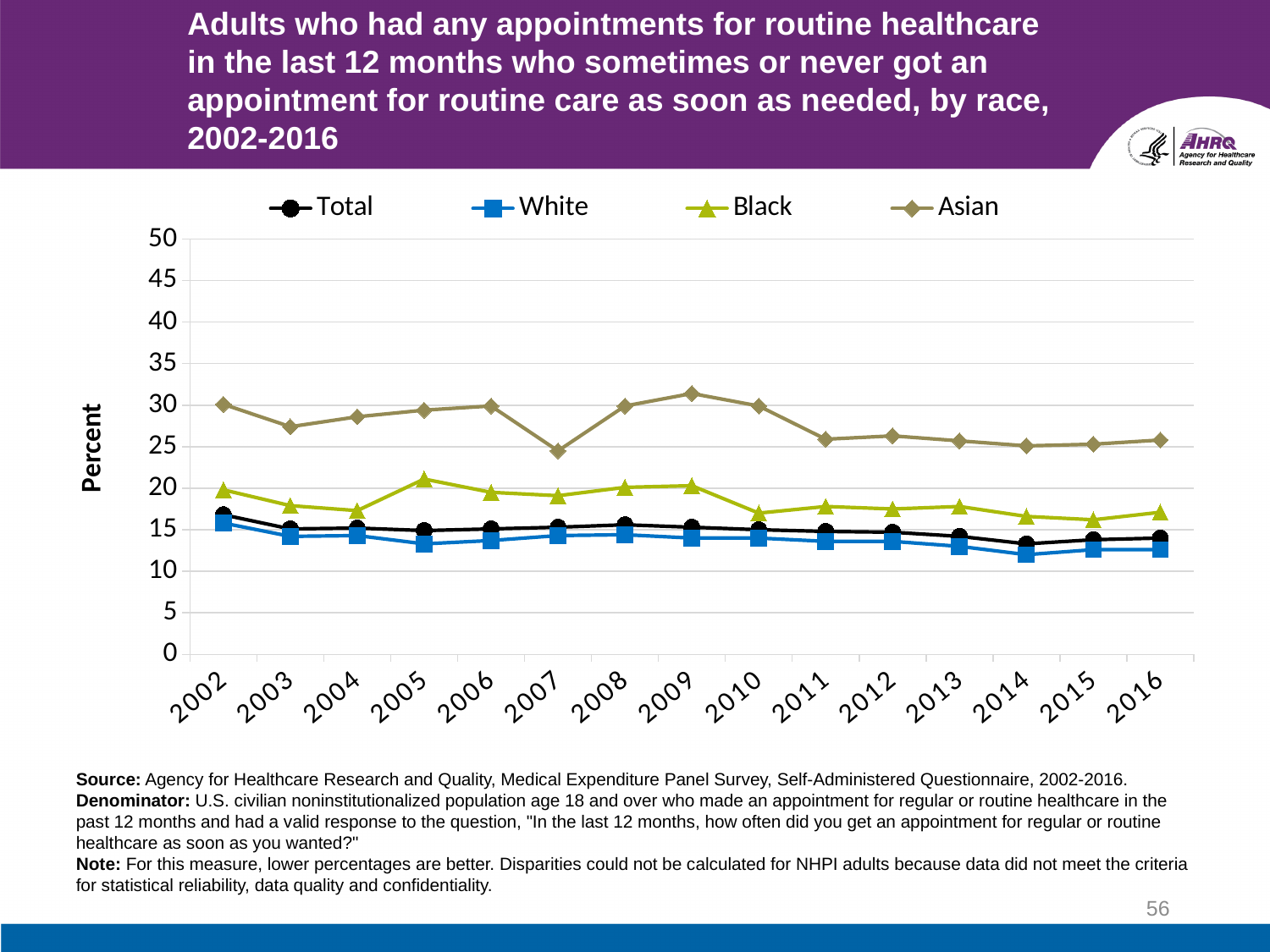
What kind of chart is shown on the slide? Line chart Which is larger in 2010, the value for Black or the value for Asian? Asian How many years are plotted along the x axis? 15 Which series has the lowest values across all years? White Is the value for Asian in 2007 greater or less than 30? less Is the value for White in 2014 greater or less than 15? less Does the Asian series rise or fall from 2010 to 2011? Fall Is the value for Asian in 2009 greater or less than 30? greater Which series has the highest values across all years? Asian What is the label on the y axis? Percent How many series does the legend list? 4 In which year does the Asian series reach its highest value? 2009